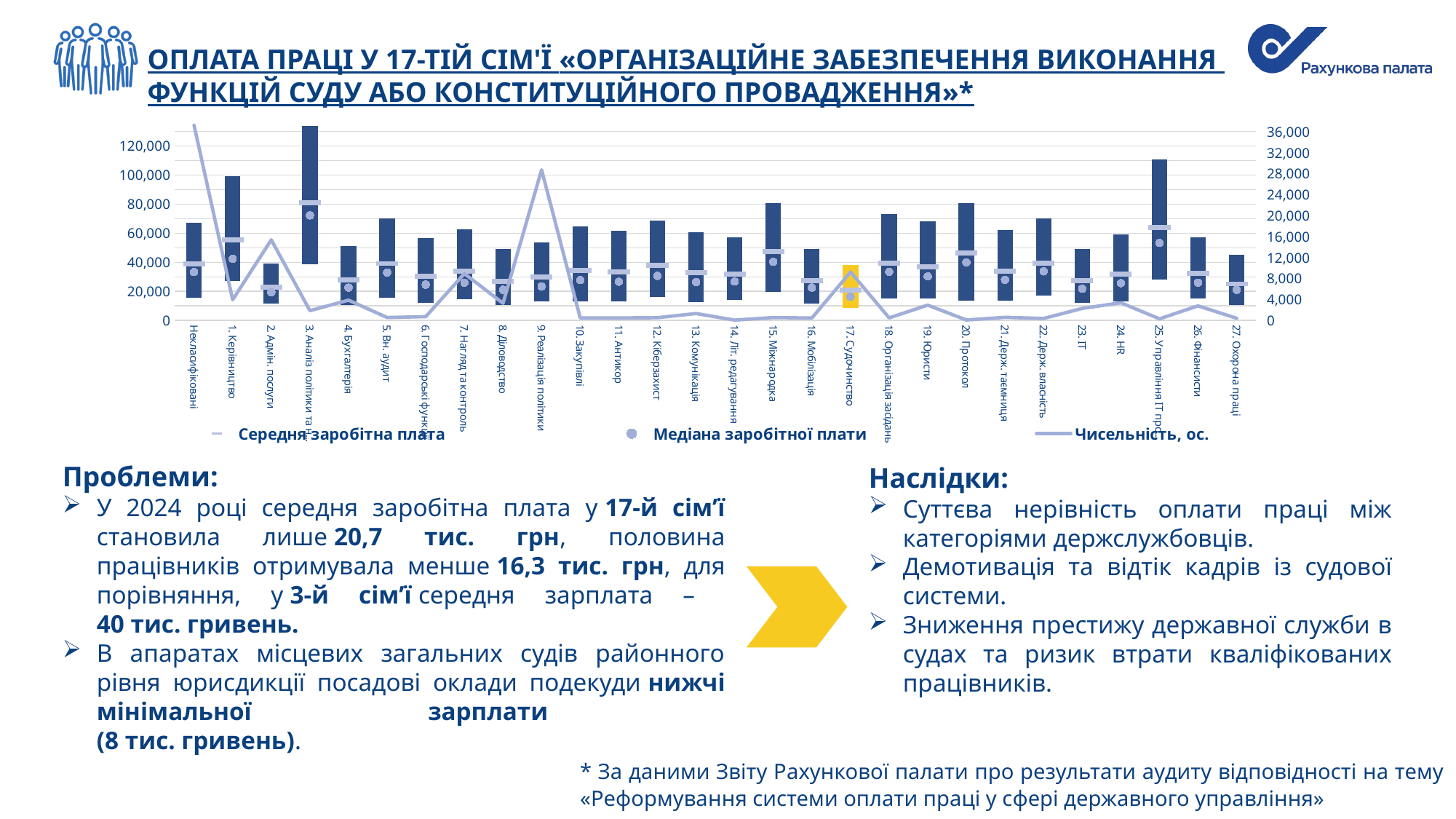
Is the average salary for 2. Адмін. послуги greater or less than 40,000? less Is the median salary for 15. Міжнародка greater or less than 20,000? greater Which category's bar is highlighted in yellow on the chart? 17. Судочинство Which has the larger average salary: 1. Керівництво or 2. Адмін. послуги? 1. Керівництво How many categories are shown along the x axis of the chart? 28 Is the headcount (Чисельність, ос.) for 9. Реалізація політики greater or less than 20,000? greater What kind of chart is shown on the slide? bar chart combined with a line Which category has the highest average salary (Середня заробітна плата) marker? 3. Аналіз політики How many series does the chart legend list? 3 Which category has the highest headcount (Чисельність, ос.) line value? Некласифіковані Which has the larger median salary: 20. Протокол or 16. Мобілізація? 20. Протокол